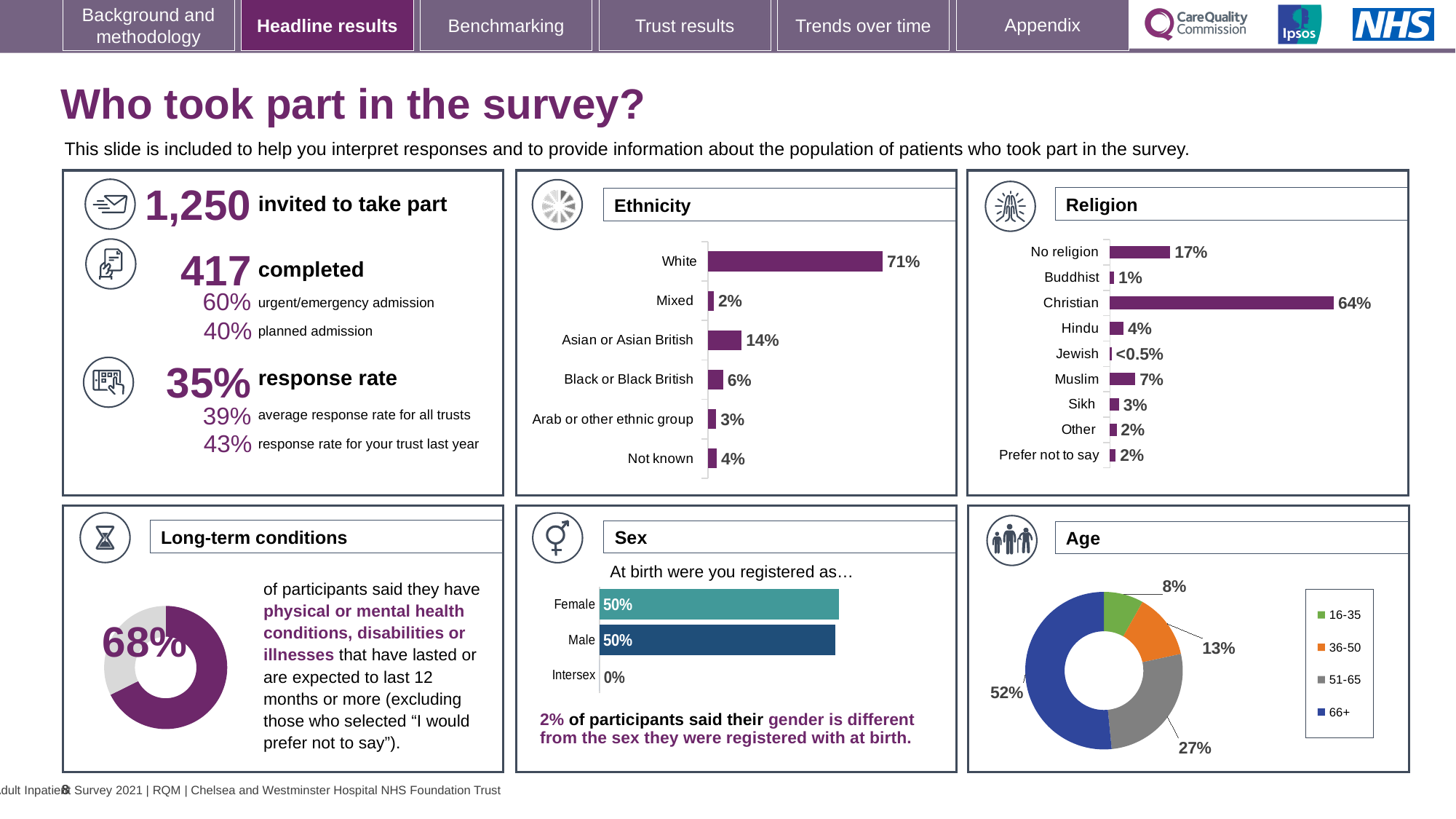
In the Religion chart, what percentage of participants were Christian? 64% In the Ethnicity chart, what is the difference between the percentages for Asian or Asian British and Black or Black British? 8% How many age groups does the legend of the Age chart list? 4 In the Ethnicity chart, which ethnic group has the lowest percentage? Mixed How many ethnic group categories are shown in the Ethnicity chart? 6 What kind of chart is used in the Age panel? Donut (pie) chart In the Ethnicity chart, what percentage of participants were White? 71% In the Sex chart, what percentage of participants were registered as Female at birth? 50% In the Age chart, what share of participants were aged 66+? 52% In the Religion chart, what value is shown for Jewish? <0.5% In the Religion chart, which religion category has the highest percentage? Christian In the Religion chart, which is larger: the percentage for Muslim or the percentage for Hindu? Muslim